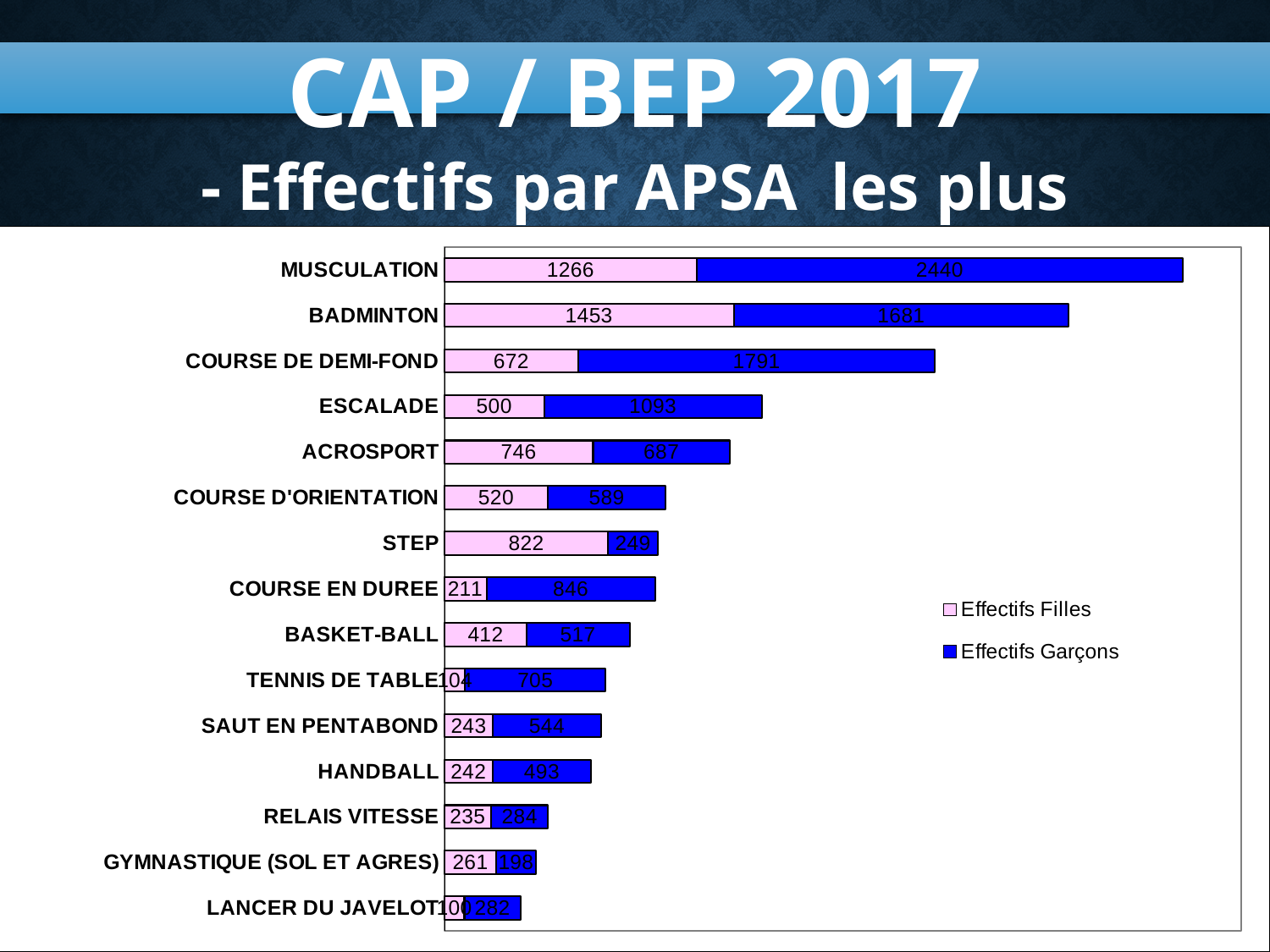
How many series does the legend list? 2 What is the total of the stacked bar for ESCALADE? 1593 How many categories are shown on the chart? 15 What kind of chart is shown on the slide? Stacked bar chart Which category has the highest value for Effectifs Garçons? MUSCULATION What is the value of Effectifs Garçons for MUSCULATION? 2440 What is the difference between Effectifs Garçons and Effectifs Filles for MUSCULATION? 1174 What is the value of Effectifs Garçons for COURSE DE DEMI-FOND? 1791 What is the value of Effectifs Filles for STEP? 822 What is the value of Effectifs Filles for BADMINTON? 1453 Which category has the highest value for Effectifs Filles? BADMINTON For ACROSPORT, which is larger: Effectifs Filles or Effectifs Garçons? Effectifs Filles